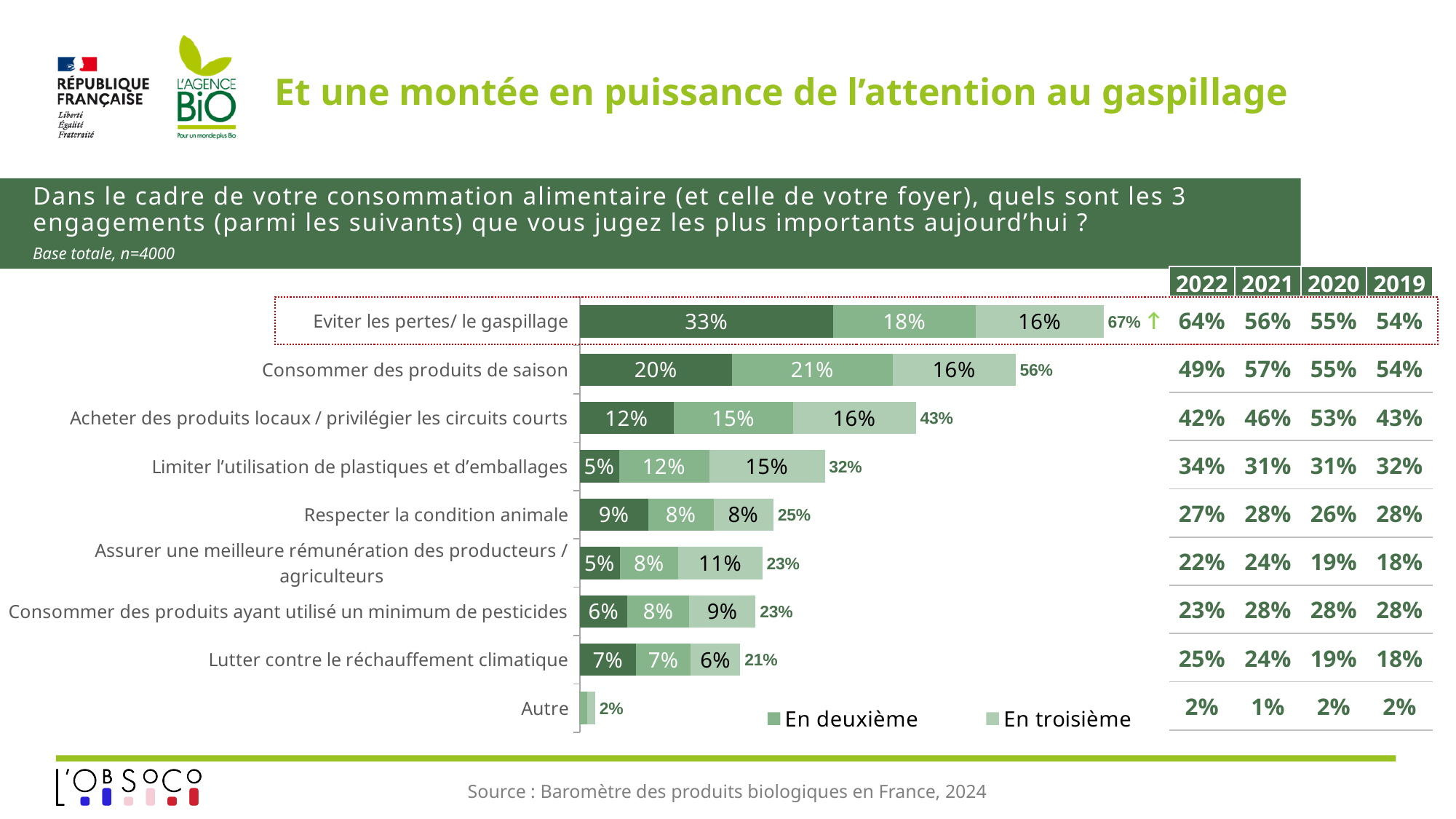
How many categories are plotted in the bar chart? 9 In the table on the right, what was the 2022 value for "Eviter les pertes/ le gaspillage"? 64% What kind of chart is shown on the slide? Bar chart What is the total of the stacked bar for "Respecter la condition animale"? 25% Which has a higher total: "Acheter des produits locaux / privilégier les circuits courts" or "Limiter l'utilisation de plastiques et d'emballages"? Acheter des produits locaux / privilégier les circuits courts What is the total percentage shown for "Eviter les pertes/ le gaspillage"? 67% Which category has the highest total percentage? Eviter les pertes/ le gaspillage What is the title of the slide? Et une montée en puissance de l'attention au gaspillage What is the difference between the totals for "Eviter les pertes/ le gaspillage" and "Consommer des produits de saison"? 11 percentage points What is the dark green (first-choice) segment value for "Consommer des produits de saison"? 20% What is the "En troisième" value for "Limiter l'utilisation de plastiques et d'emballages"? 15% Which category has the lowest total percentage? Autre